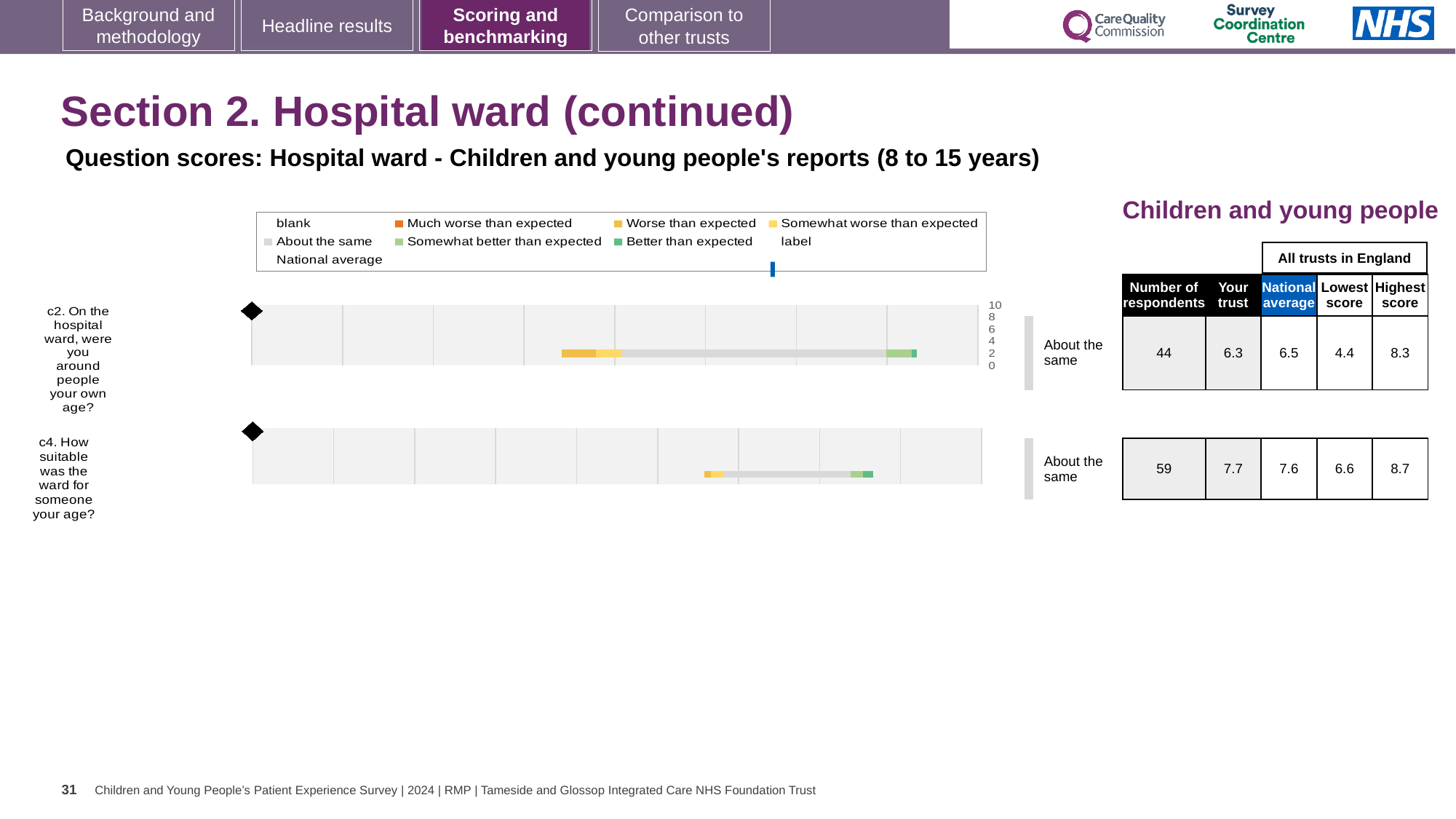
What kind of chart is used to show the question scores on this slide? bar chart Which question has the higher 'Your trust' score, c2 or c4? c4 How many questions are plotted in the chart on this slide? 2 How many respondents answered question c4? 59 What is the 'Your trust' score for question c2 (On the hospital ward, were you around people your own age?)? 6.3 By how much does the national average exceed the trust's score for question c2? 0.2 What benchmark category is shown next to the bar for question c4? About the same Which of the two questions has the lower national average score? c2 What is the national average score for question c2? 6.5 What is the difference between the highest score and the lowest score for question c4? 2.1 What is the 'Your trust' score for question c4 (How suitable was the ward for someone your age?)? 7.7 What is the highest score among all trusts in England for question c2? 8.3